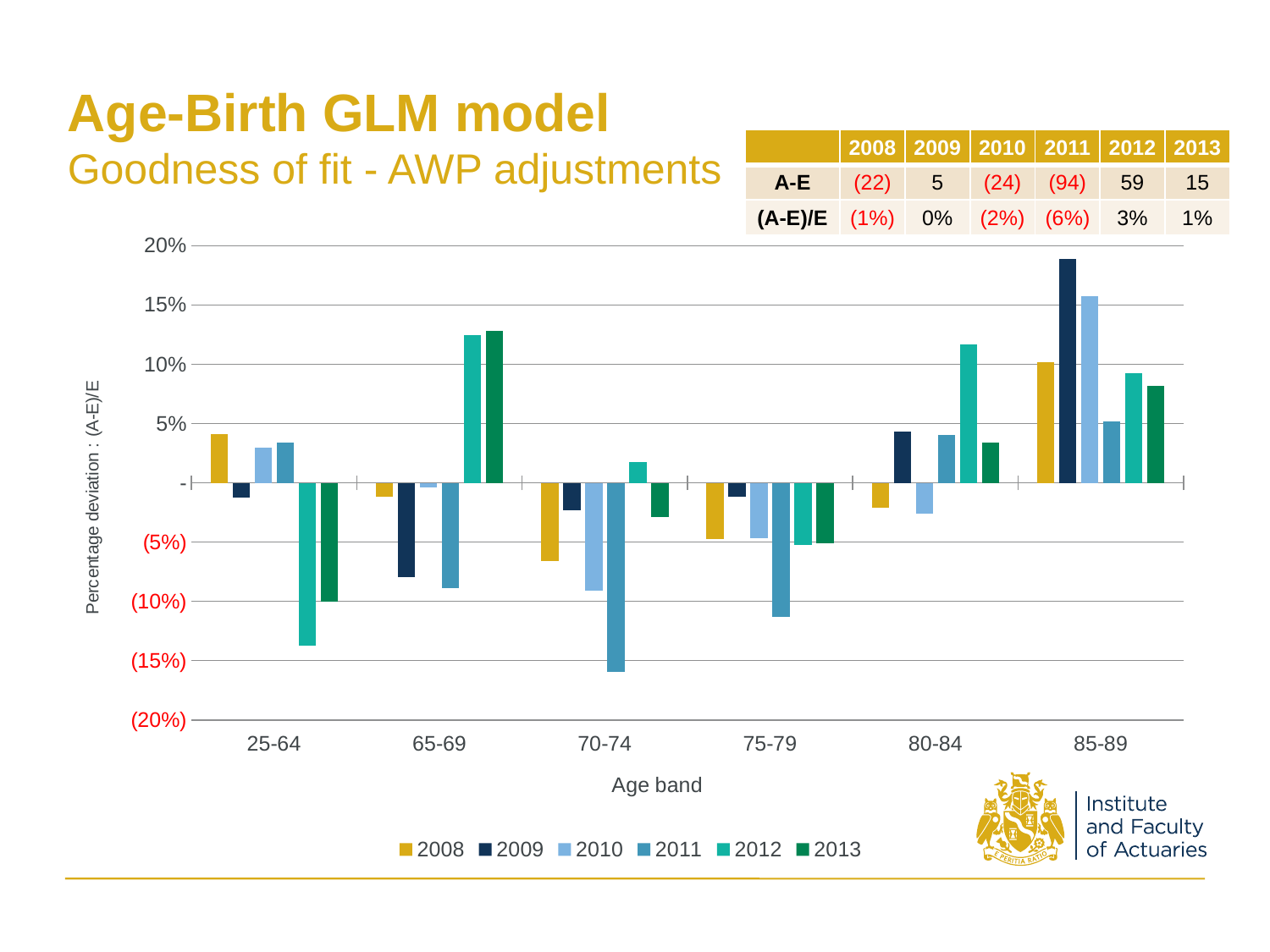
In the 85-89 age band, which is larger, the 2009 bar or the 2010 bar? 2009 What is the title of the chart's vertical axis? Percentage deviation : (A-E)/E Which year has the highest bar in the 85-89 age band? 2009 What is the title of the chart's horizontal axis? Age band What kind of chart is shown on the slide? bar chart How many series does the chart's legend list? 6 Which age band contains the lowest bar in the whole chart? 70-74 Which year has the lowest bar in the 25-64 age band? 2012 Is the value for 2011 in the 70-74 age band greater or less than (10%)? less Is the value for 2009 in the 85-89 age band greater or less than 15%? greater Is the value for 2012 in the 65-69 age band greater or less than 10%? greater How many age bands are shown on the x axis of the chart? 6